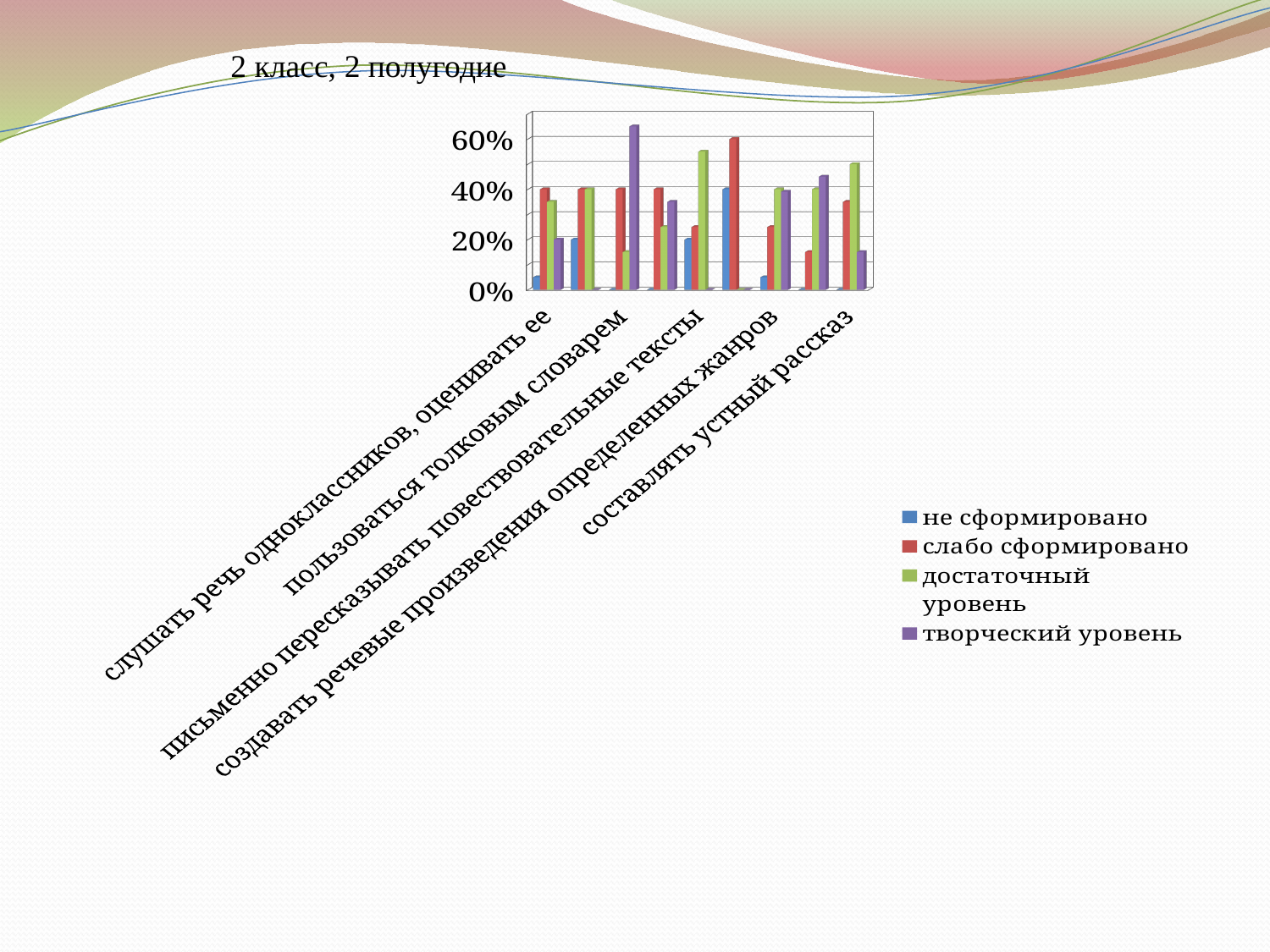
How many series does the legend list? 4 Is the tallest bar in the chart greater or less than 60%? greater In the leftmost group of bars, which is larger: слабо сформировано or не сформировано? слабо сформировано Which series has the tallest bar in the rightmost group of bars? достаточный уровень Which series does the tallest bar in the chart belong to? творческий уровень In the rightmost group of bars, is the value for достаточный уровень greater or less than 40%? greater What is the highest value labelled on the vertical axis? 60% What kind of chart is shown on the slide? bar chart Which legend entry is shown in purple? творческий уровень What is the title of the slide above the chart? 2 класс, 2 полугодие In the leftmost group of bars, is the value for не сформировано greater or less than 20%? less